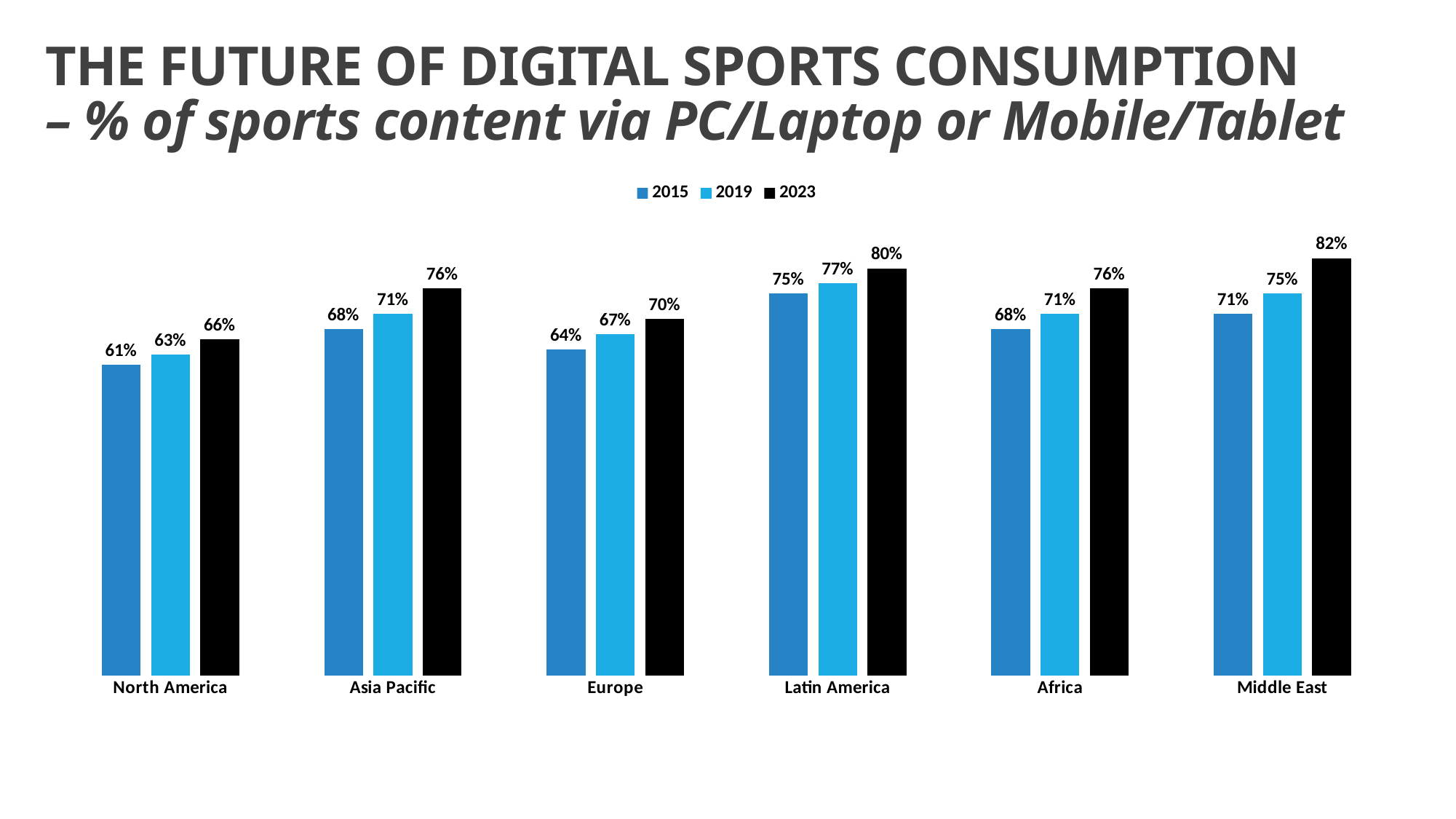
Which colour represents the 2023 series in the legend? Black What kind of chart is shown on the slide? Bar chart How many regions are shown on the x axis? 6 What is the value for North America in 2015? 61% Which is larger: the 2019 value for Latin America or the 2019 value for Africa? Latin America Which region has the highest value in 2023? Middle East Which region has the lowest value in 2015? North America What is the difference between the 2023 and 2015 values for Asia Pacific? 8% What is the value for Middle East in 2023? 82% How many series does the legend list? 3 For Latin America, do the values rise or fall from 2015 to 2023? Rise What is the value for Europe in 2019? 67%